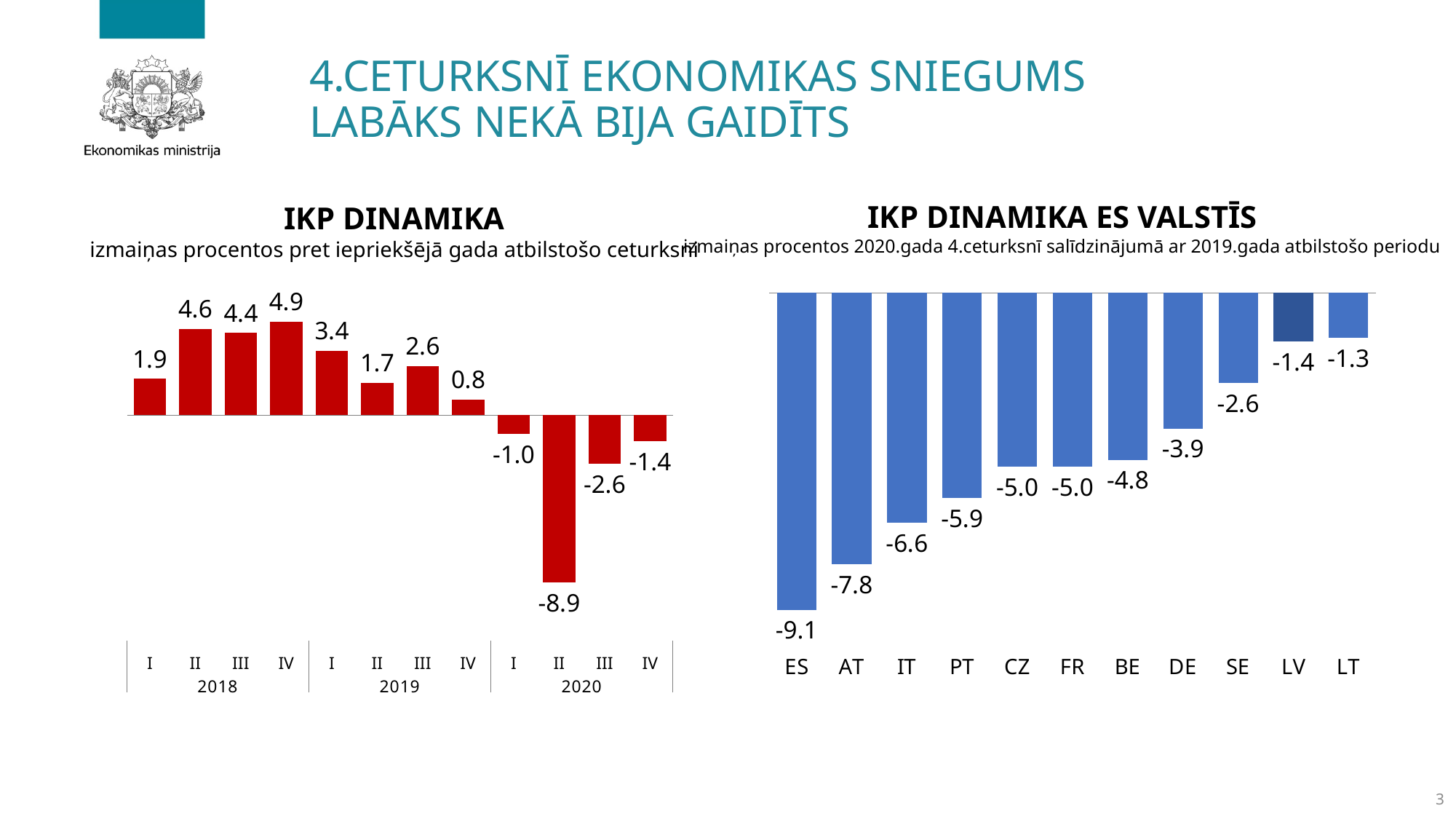
In the IKP DINAMIKA chart, which quarter has the lowest value? II 2020 What kind of chart is the IKP DINAMIKA ES VALSTĪS chart? bar chart In the IKP DINAMIKA chart, what is the value for quarter IV of 2018? 4.9 In the IKP DINAMIKA ES VALSTĪS chart, which is larger, the value for DE or the value for IT? DE In the IKP DINAMIKA chart, how many quarters are plotted? 12 In the IKP DINAMIKA ES VALSTĪS chart, what is the value for LV? -1.4 In the IKP DINAMIKA chart, what is the value for quarter II of 2020? -8.9 In the IKP DINAMIKA ES VALSTĪS chart, which country has the lowest value? ES In the IKP DINAMIKA ES VALSTĪS chart, how many countries are plotted? 11 In the IKP DINAMIKA chart, do the values rise or fall from quarter IV of 2018 to quarter IV of 2019? fall In the IKP DINAMIKA ES VALSTĪS chart, which country has the highest value? LT In the IKP DINAMIKA chart, what is the difference between quarter I of 2019 and quarter IV of 2019? 2.6